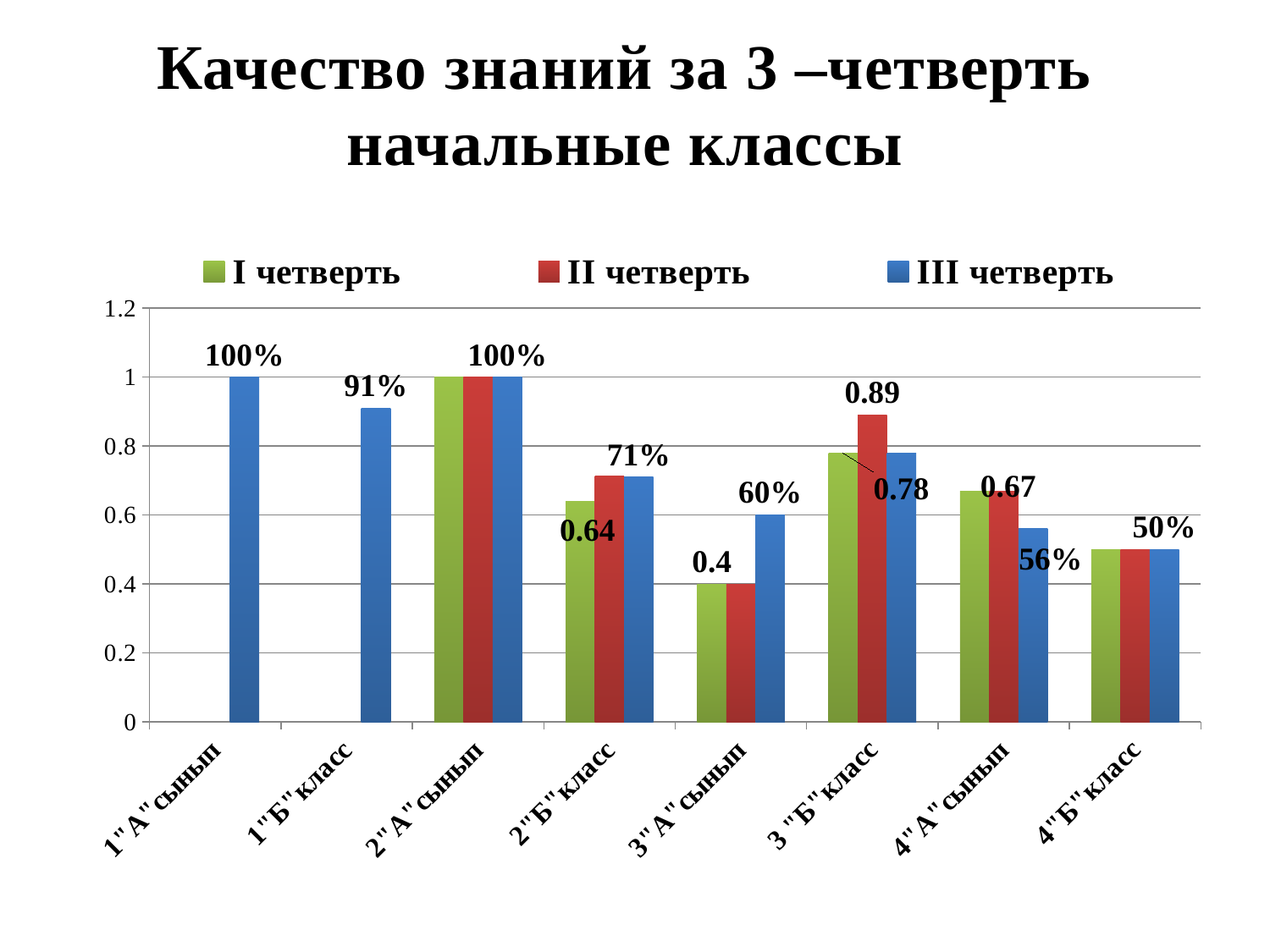
What is the value of II четверть for 3"Б" класс? 0.89 Which category has the lowest value for III четверть? 4"Б" класс What is the value of III четверть for 1"Б" класс? 91% What kind of chart is shown on the slide? bar chart For 3"Б" класс, which is larger: I четверть or II четверть? II четверть How many series does the legend list? 3 What is the value of III четверть for 1"А" сынып? 100% What is the value of III четверть for 4"Б" класс? 50% Is the value of II четверть for 4"А" сынып greater or less than 0.6? greater What is the difference between II четверть and I четверть for 3"Б" класс? 0.11 How many categories are shown on the x axis? 8 What is the value of III четверть for 3"А" сынып? 60%